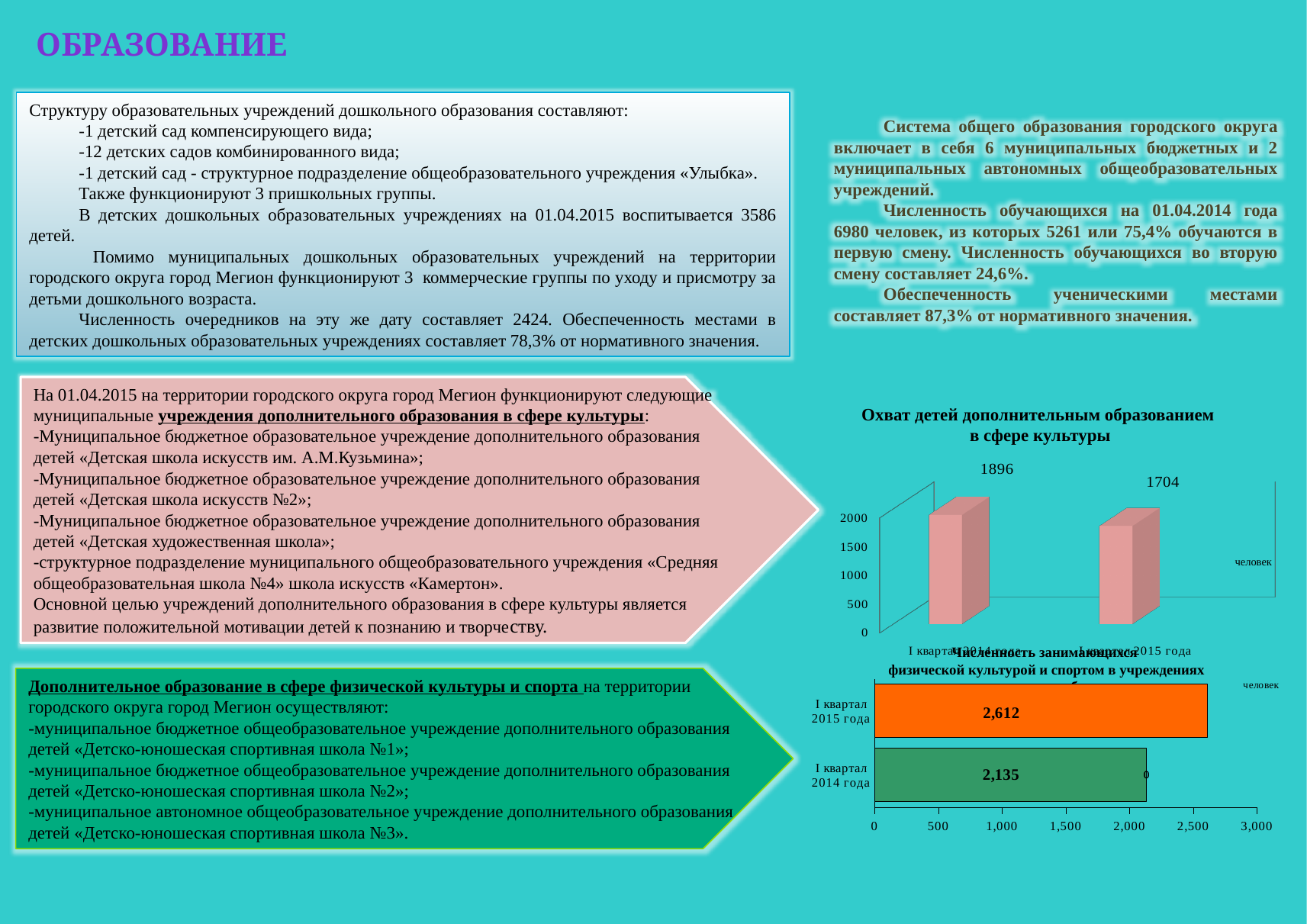
In the lower-right chart on the number of people engaged in physical culture and sport, which period has the larger value? I квартал 2015 года In the chart 'Охват детей дополнительным образованием в сфере культуры', do the values rise or fall from I квартал 2014 года to I квартал 2015 года? fall In the lower-right chart on the number of people engaged in physical culture and sport, what is the difference between the 2015 and 2014 values? 477 What type of chart is the upper-right chart 'Охват детей дополнительным образованием в сфере культуры'? bar chart In the lower-right chart on the number of people engaged in physical culture and sport, what is the value for I квартал 2014 года? 2,135 In the chart 'Охват детей дополнительным образованием в сфере культуры', what is the value for I квартал 2014 года? 1896 In the chart 'Охват детей дополнительным образованием в сфере культуры', what is the value for I квартал 2015 года? 1704 In the chart 'Охват детей дополнительным образованием в сфере культуры', what is the difference between the 2014 and 2015 values? 192 In the chart 'Охват детей дополнительным образованием в сфере культуры', which period has the higher value? I квартал 2014 года How many bars are plotted in the chart 'Охват детей дополнительным образованием в сфере культуры'? 2 In the lower-right chart on the number of people engaged in physical culture and sport, what is the value for I квартал 2015 года? 2,612 In the lower-right chart on the number of people engaged in physical culture and sport, what colour is the bar for I квартал 2015 года? orange